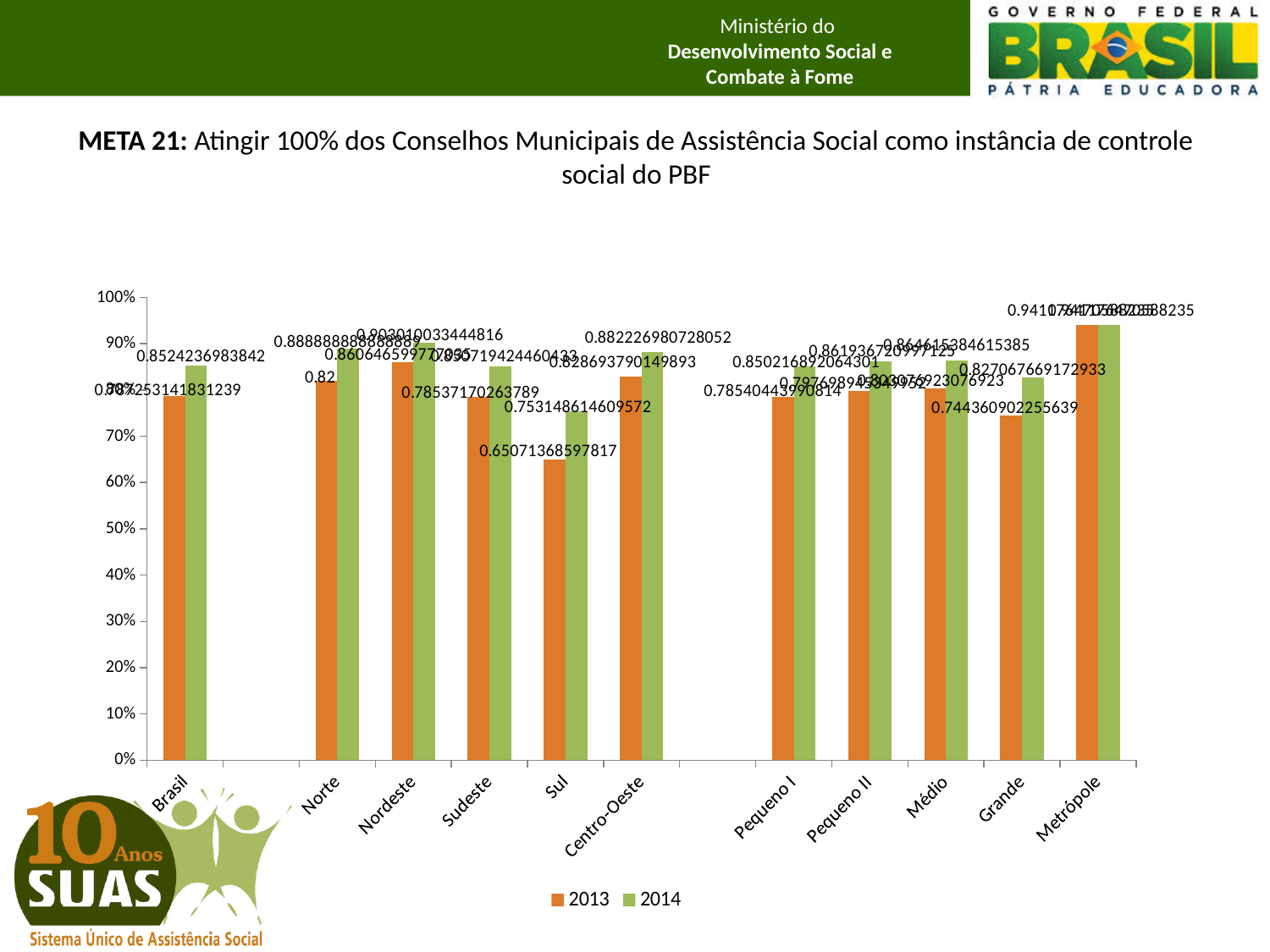
Which category has the lowest 2013 value? Sul Which category has the highest 2014 value? Metrópole What is the 2013 value for Sul? 0.65071368597817 What is the 2013 value for Grande? 0.744360902255639 What is the 2013 value for Norte? 0.82 What is the 2014 value for Grande? 0.827067669172933 How many series does the chart legend list? 2 What kind of chart is shown on the slide? bar chart Is the 2014 value for Metrópole greater or less than 90%? greater What are the two series named in the chart legend? 2013 and 2014 How many categories are shown along the x axis of the chart? 11 What is the 2014 value for Sul? 0.753148614609572